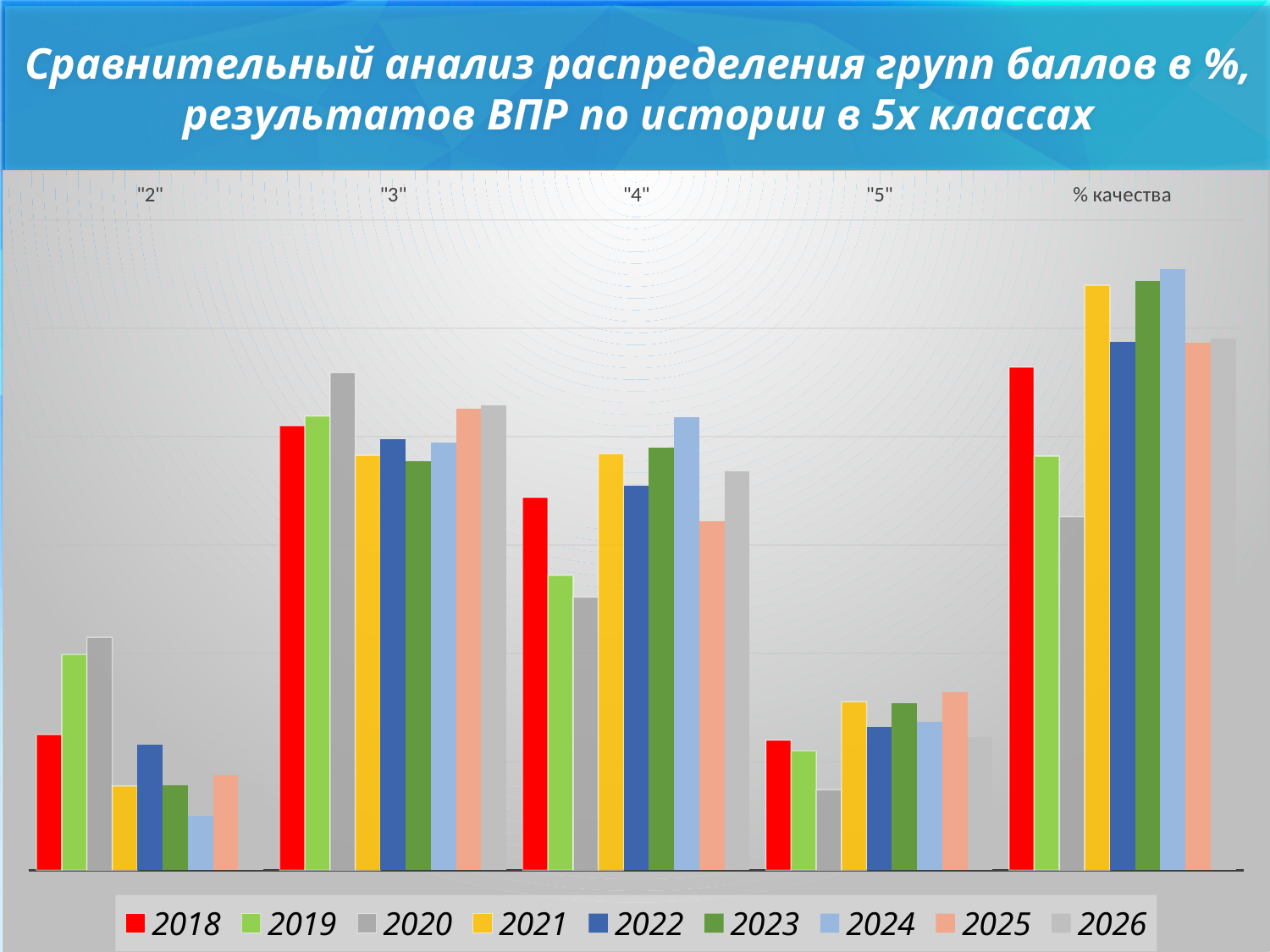
In the "4" category, which year has the highest bar? 2024 What kind of chart is shown on the slide? bar chart In the "3" category, which year has the highest bar? 2020 In the "2" category, which year has the lowest bar? 2024 How many categories are shown along the x axis of the chart? 5 How many series does the chart's legend list? 9 What colour are the bars for the 2018 series? red In the "2" category, which is larger: the value for 2018 or for 2019? 2019 In the "5" category, which year has the lowest bar? 2020 In the "% качества" category, which year has the lowest bar? 2020 In the "% качества" category, which is larger: the value for 2018 or for 2019? 2018 In the "2" category, which year has the highest bar? 2020